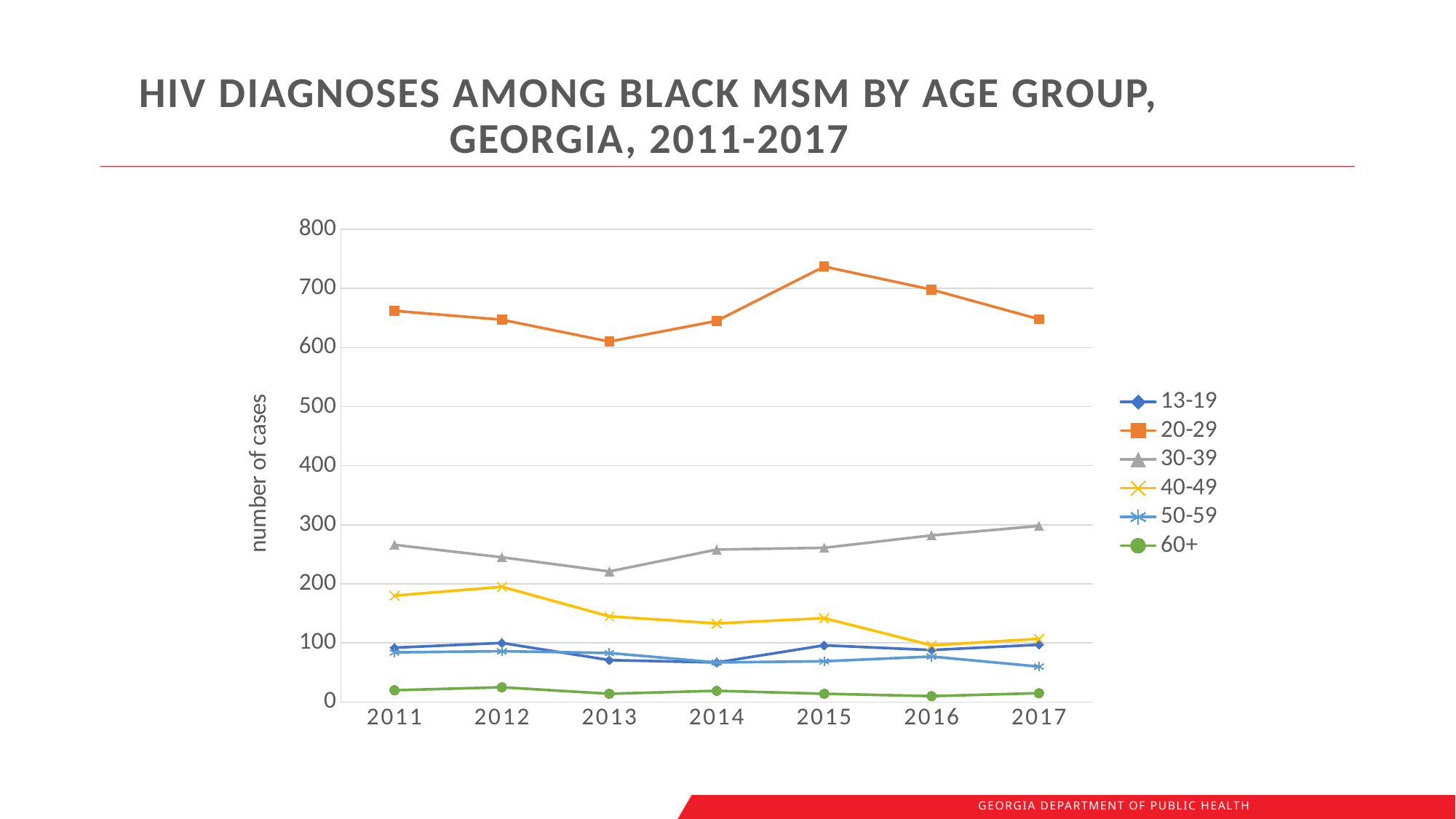
Which is larger for the 20-29 age group: the value in 2015 or the value in 2016? 2015 Does the 30-39 age group line rise or fall from 2013 to 2017? rise In which year does the 20-29 age group reach its highest value? 2015 How many years are plotted along the x axis? 7 Which age group has the lowest number of cases in every year shown? 60+ Is the value for the 30-39 age group in 2013 greater or less than 250? less In which year does the 20-29 age group reach its lowest value? 2013 Is the value for the 20-29 age group in 2015 greater or less than 700? greater What kind of chart is shown on the slide? line chart How many age groups does the legend list? 6 Which age group has the highest number of cases in every year shown? 20-29 Is the value for the 40-49 age group in 2013 greater or less than 200? less